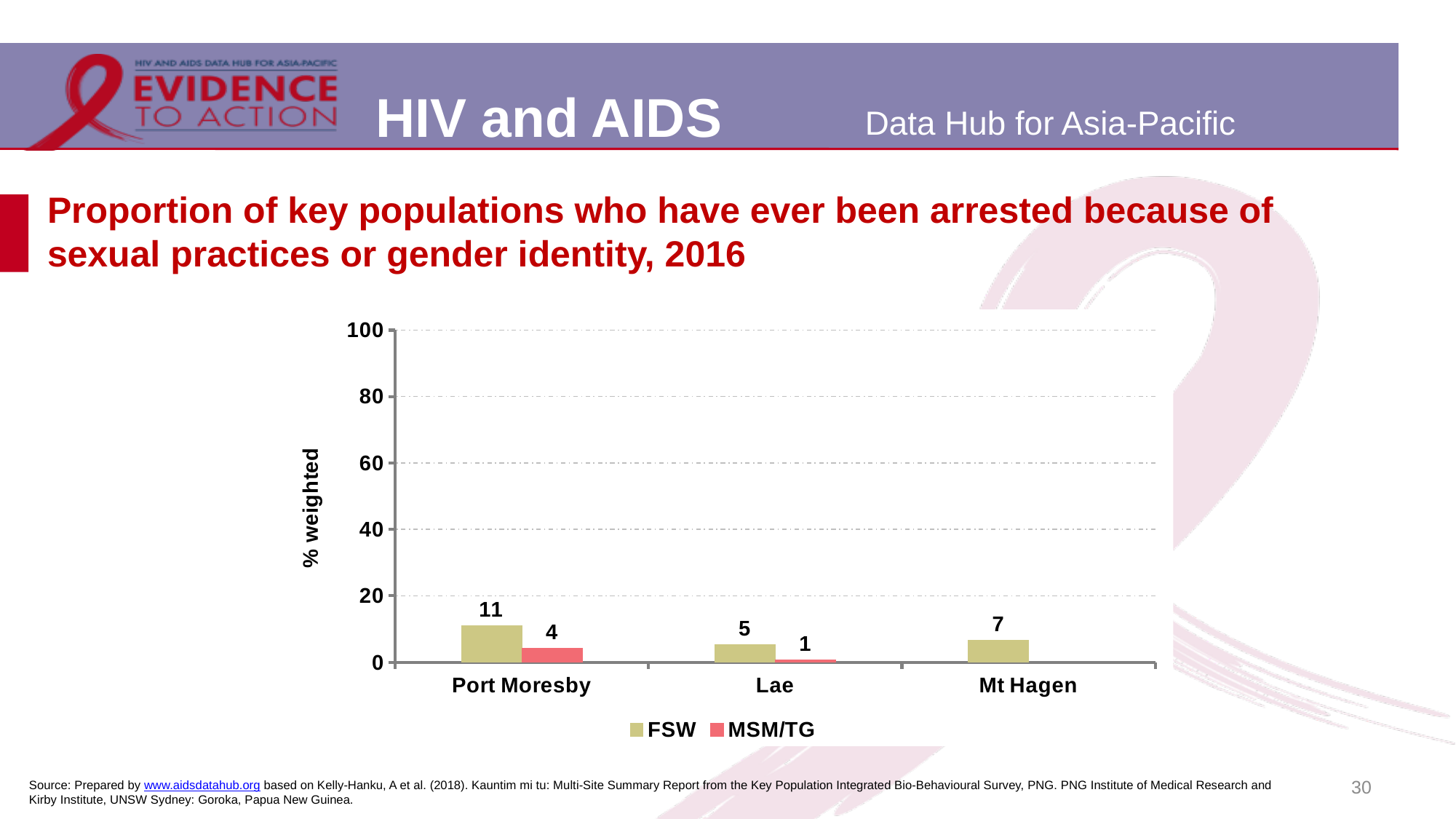
How many series does the legend list? 2 Which is larger, the MSM/TG value for Port Moresby or the MSM/TG value for Lae? Port Moresby What is the MSM/TG value for Lae? 1 What kind of chart is shown? bar chart Which city has the highest FSW value? Port Moresby What is the label of the y axis? % weighted Which city has the lowest FSW value? Lae What is the difference between the FSW and MSM/TG values for Port Moresby? 7 Is the FSW value for Port Moresby greater or less than 20? less What is the FSW value for Port Moresby? 11 How many cities are shown on the x axis? 3 What is the FSW value for Mt Hagen? 7